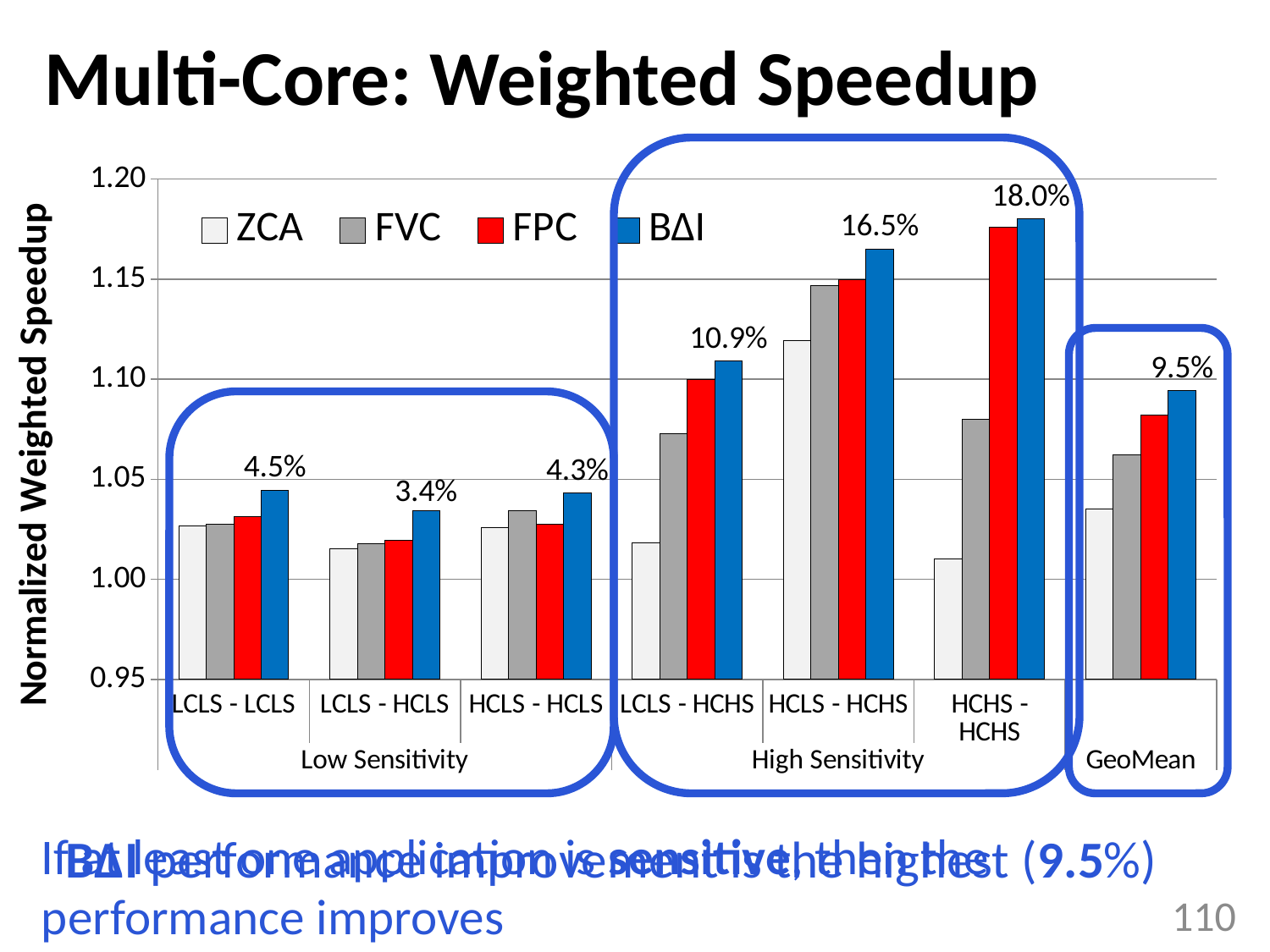
How many workload categories are shown along the x axis? 7 What is the title of the y axis? Normalized Weighted Speedup How many series does the legend list? 4 What percentage label is printed above the BΔI bar for GeoMean? 9.5% Which is larger, the ZCA bar for HCLS - HCHS or the ZCA bar for HCHS - HCHS? HCLS - HCHS Is the BΔI value for HCHS - HCHS greater or less than 1.15? greater What kind of chart is shown on the slide? bar chart What percentage label is printed above the BΔI bar for HCHS - HCHS? 18.0% What percentage label is printed above the BΔI bar for LCLS - HCLS? 3.4% Is the ZCA value for HCHS - HCHS greater or less than 1.05? less Which category has the shortest BΔI bar? LCLS - HCLS Which category has the tallest BΔI bar? HCHS - HCHS